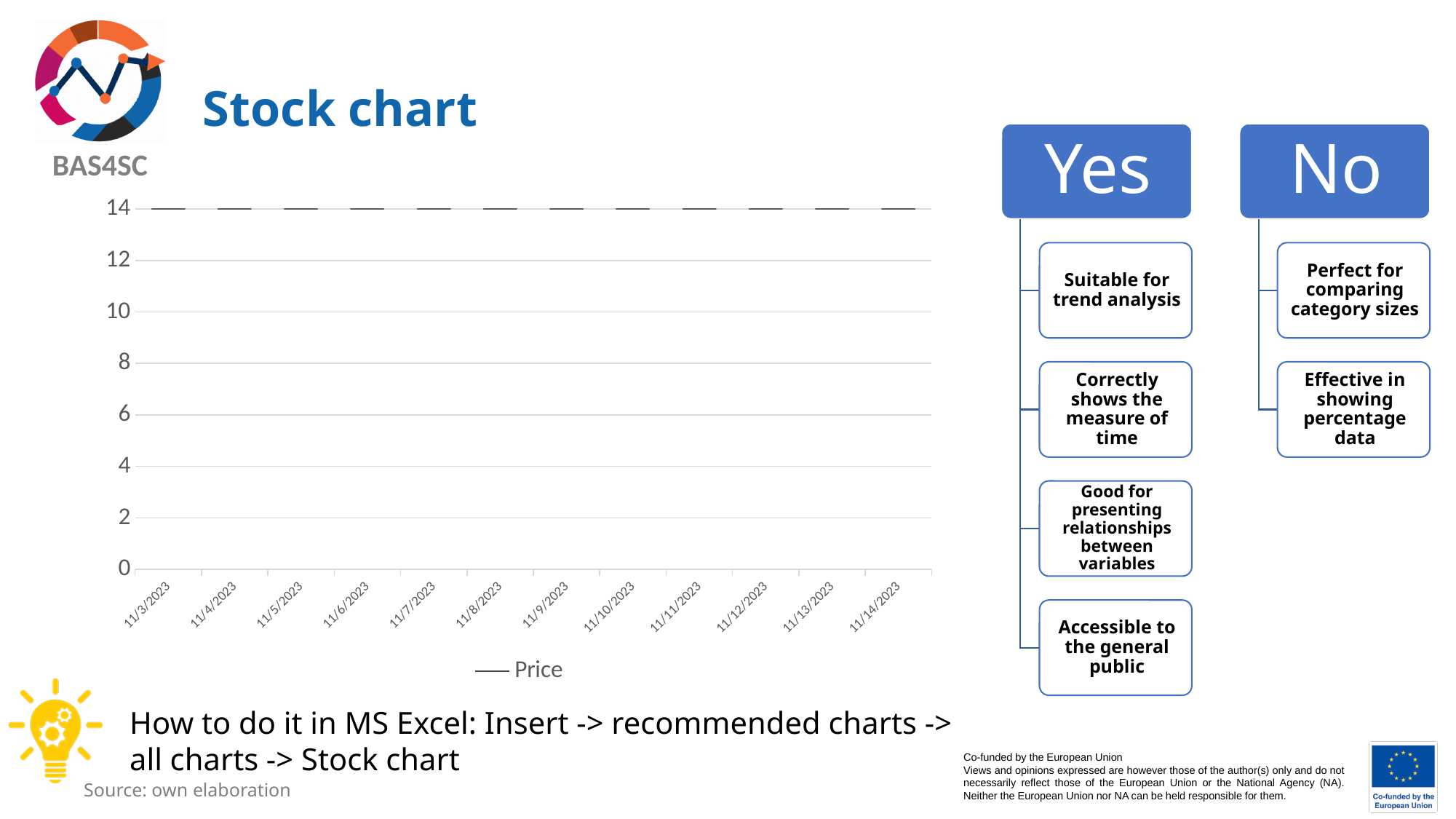
What is the highest value shown on the y axis of the chart? 14 What is the first date shown on the x axis? 11/3/2023 Do the plotted values rise, fall, or stay flat from 11/3/2023 to 11/14/2023? stay flat What is the name of the series in the chart legend? Price Is the value for 11/14/2023 greater or less than 12? greater How many series does the chart legend list? 1 What kind of chart is shown on the slide? Stock chart How many dates are shown on the x axis of the chart? 12 What is the last date shown on the x axis? 11/14/2023 What is the title of the chart on the slide? Stock chart Is the value for 11/8/2023 greater or less than 8? greater Is the value for 11/3/2023 greater or less than 10? greater